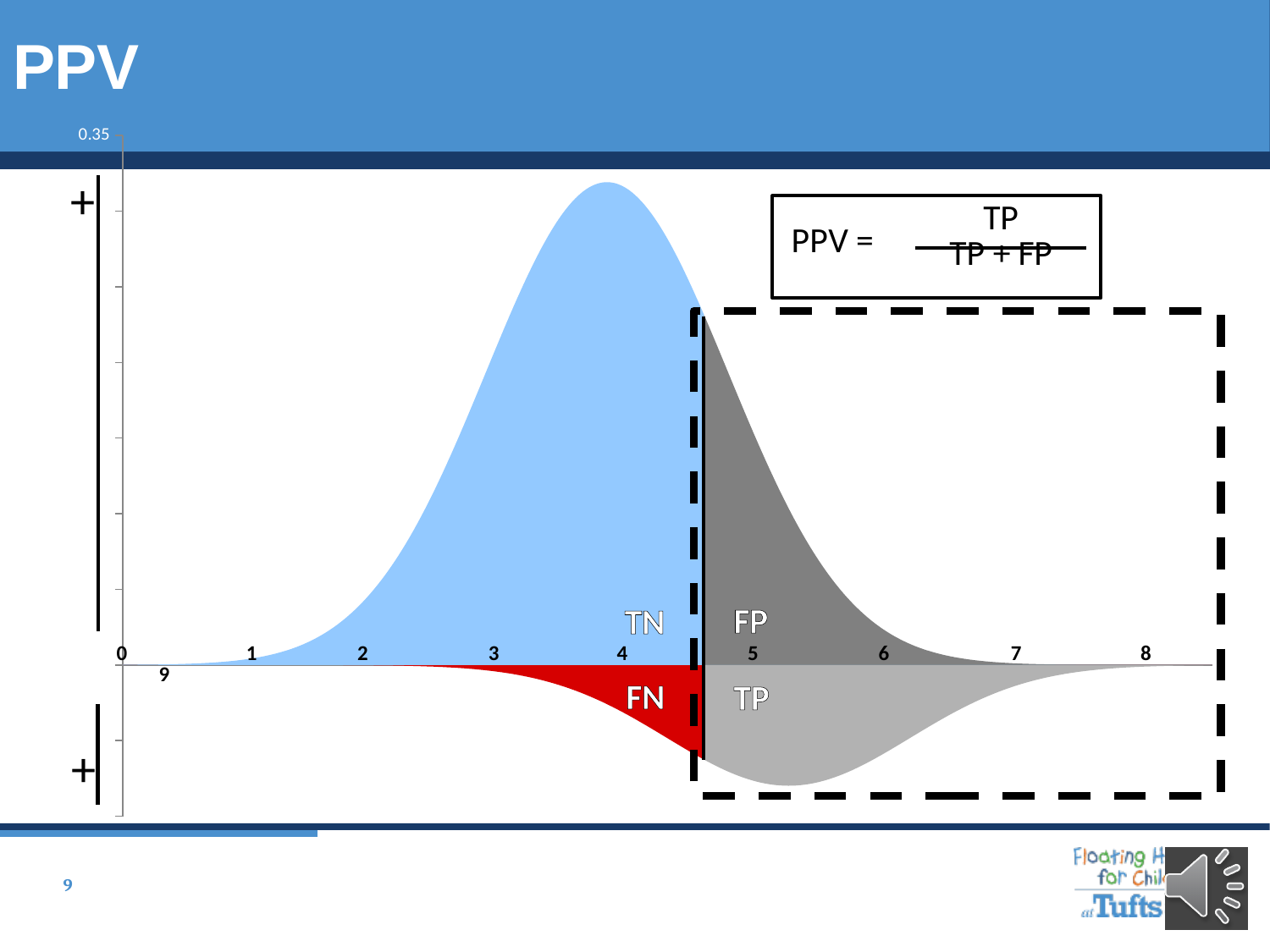
How many labeled regions (TN, FP, FN, TP) are shown on the chart? 4 Which two region labels are enclosed by the dashed box on the chart? FP and TP What is the title of the slide containing the chart? PPV How many tick labels from 0 to 8 appear along the x axis of the chart? 9 According to the formula box on the slide, what is the denominator of PPV? TP + FP Is the peak of the upper (blue) distribution greater or less than 0.35 on the y axis? less Which region label is shown in the light blue shaded area of the chart? TN What is the highest value labeled on the y axis of the chart? 0.35 What kind of chart is shown on the slide? area chart Which region label appears directly below FP on the chart? TP According to the formula box on the slide, what is the numerator of PPV? TP Which region label is shown in the red shaded area of the chart? FN